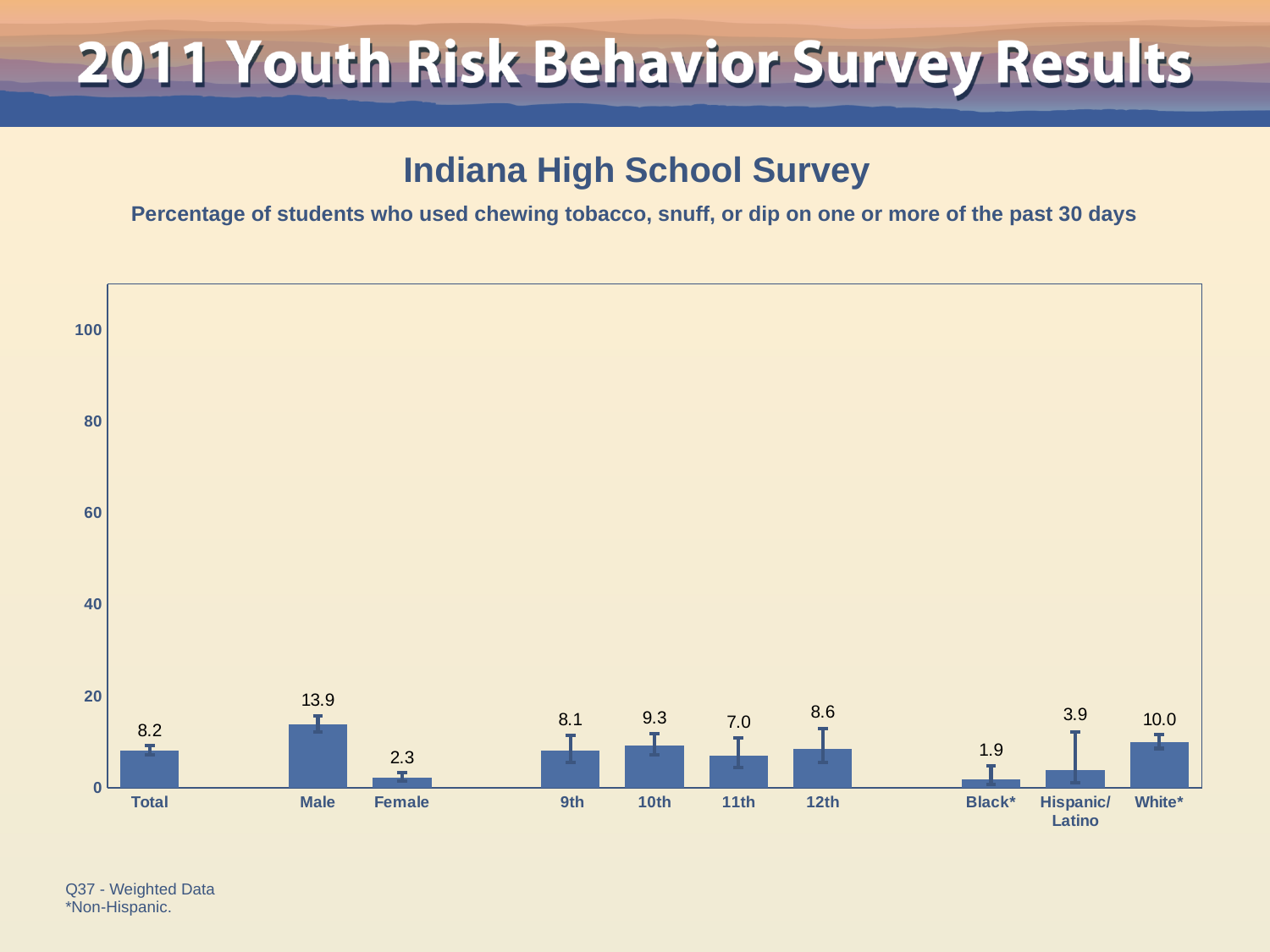
What is the value for Female? 2.3 Which is larger, the value for 10th grade or 12th grade? 10th What kind of chart is shown? bar chart What is the value for Total? 8.2 What is the value for Male? 13.9 What is the value for Black*? 1.9 Which category has the highest value? Male What is the value for 11th grade? 7.0 Which category has the lowest value? Black* How many categories are shown on the x axis? 10 What is the difference between the values for Male and Female? 11.6 Is the value for White* greater or less than 20? less